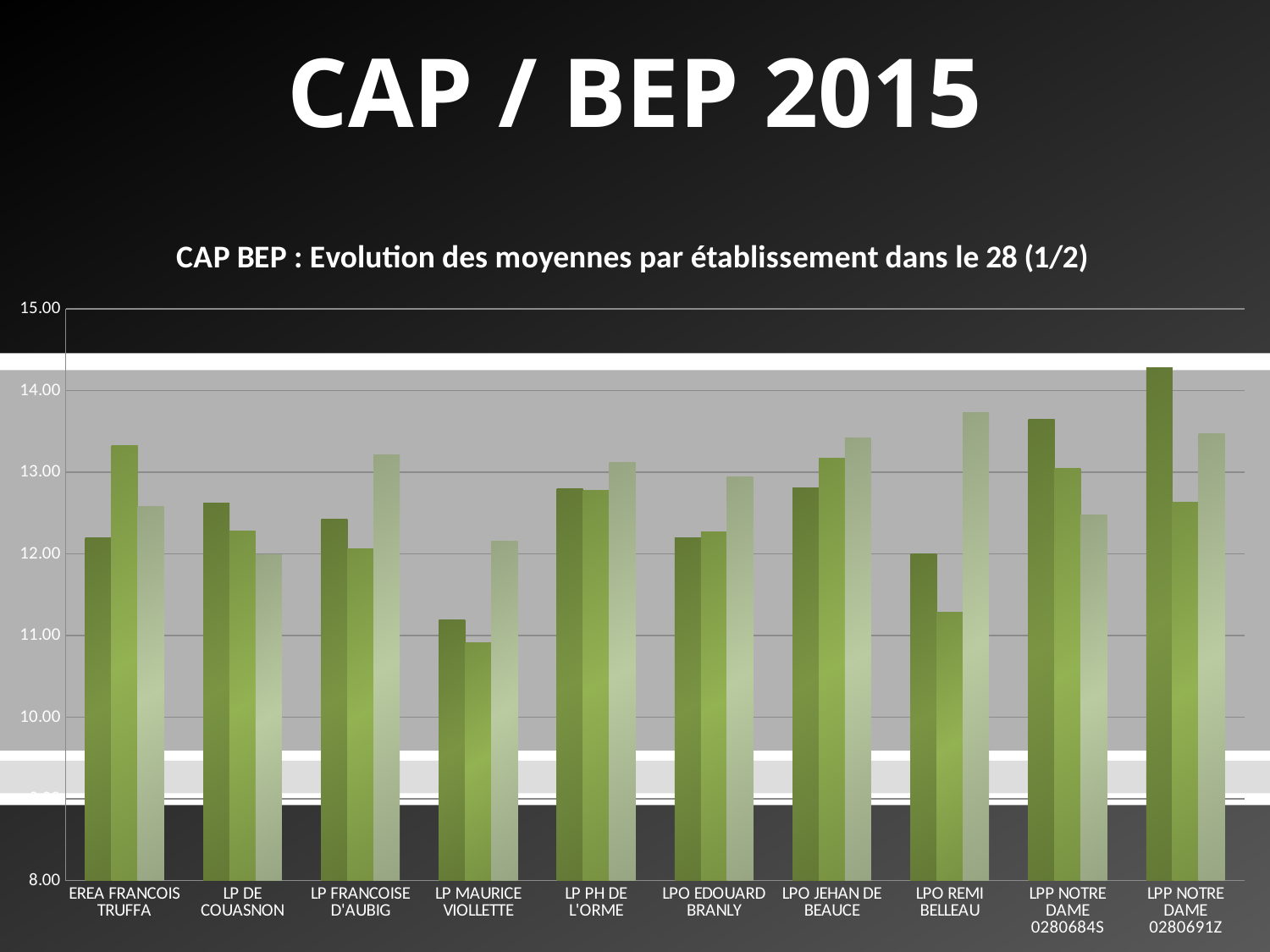
Which is larger: the first (leftmost) bar for LPP NOTRE DAME 0280691Z or the first (leftmost) bar for EREA FRANCOIS TRUFFA? LPP NOTRE DAME 0280691Z What is the title of the chart? CAP BEP : Evolution des moyennes par établissement dans le 28 (1/2) Is the value of the second (middle) bar for LPO REMI BELLEAU greater or less than 12.00? less What kind of chart is shown on the slide? Bar chart How many establishments (categories) are shown on the x axis of the chart? 10 Which establishment has the tallest bar in the chart? LPP NOTRE DAME 0280691Z Which is larger: the third (rightmost) bar for LPO REMI BELLEAU or the third (rightmost) bar for LP MAURICE VIOLLETTE? LPO REMI BELLEAU Which establishment has the shortest bar in the chart? LP MAURICE VIOLLETTE How many bars are plotted for each establishment in the chart? 3 Is the value of the second (middle) bar for LP MAURICE VIOLLETTE greater or less than 11.00? less Is the value of the third (rightmost) bar for LPO REMI BELLEAU greater or less than 13.00? greater